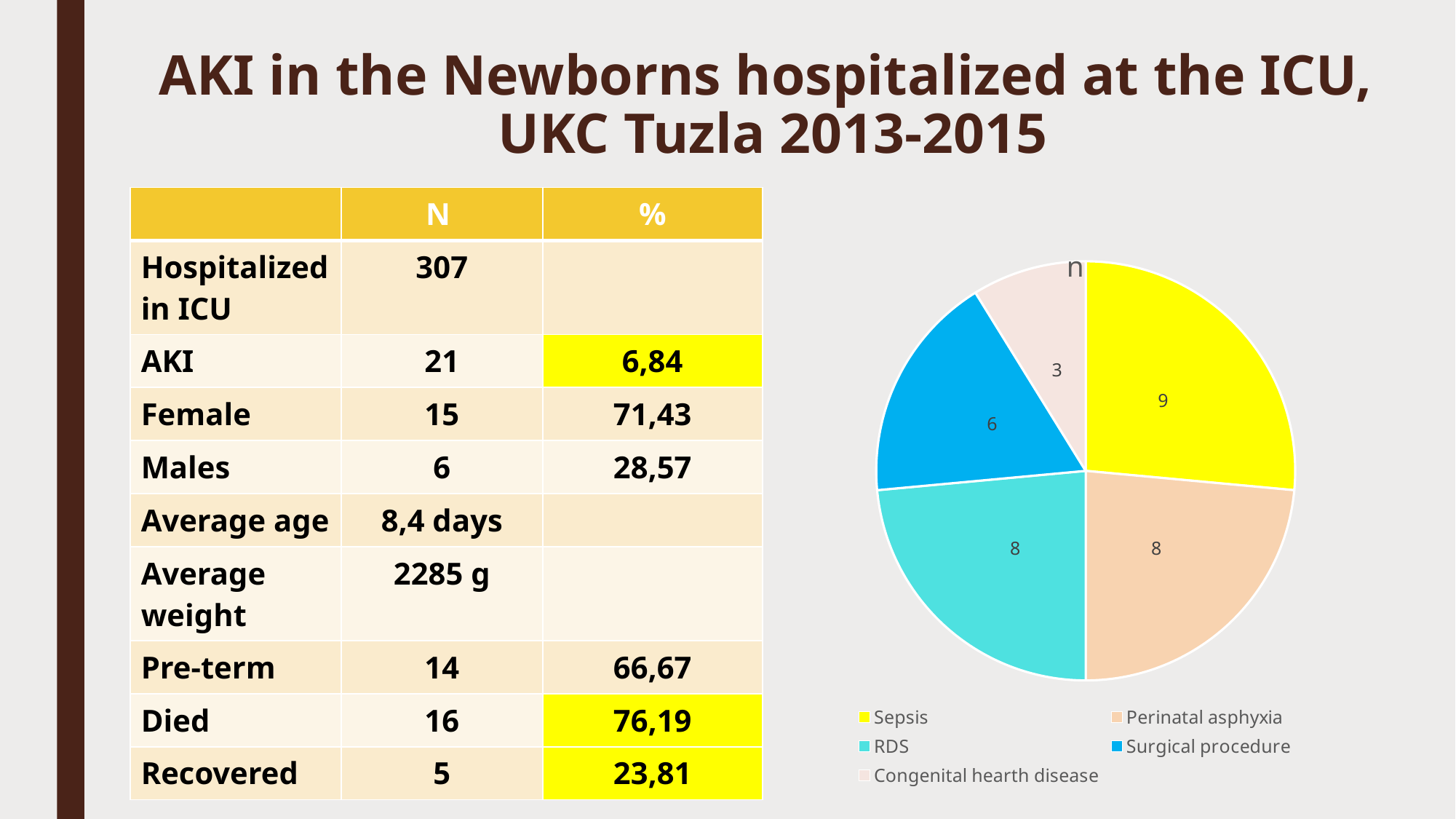
Which is larger, the value for Sepsis or the value for Surgical procedure? Sepsis Which category has the largest slice in the pie chart? Sepsis What is the difference between the values for Sepsis and Congenital hearth disease? 6 How many categories does the pie chart have? 5 What is the value for Sepsis in the pie chart? 9 What is the value for Surgical procedure in the pie chart? 6 What kind of chart is shown on the slide? pie chart Which category has the smallest slice in the pie chart? Congenital hearth disease What is the title of the pie chart? n What is the value for RDS in the pie chart? 8 What is the value for Congenital hearth disease in the pie chart? 3 What is the total of all the slice values in the pie chart? 34